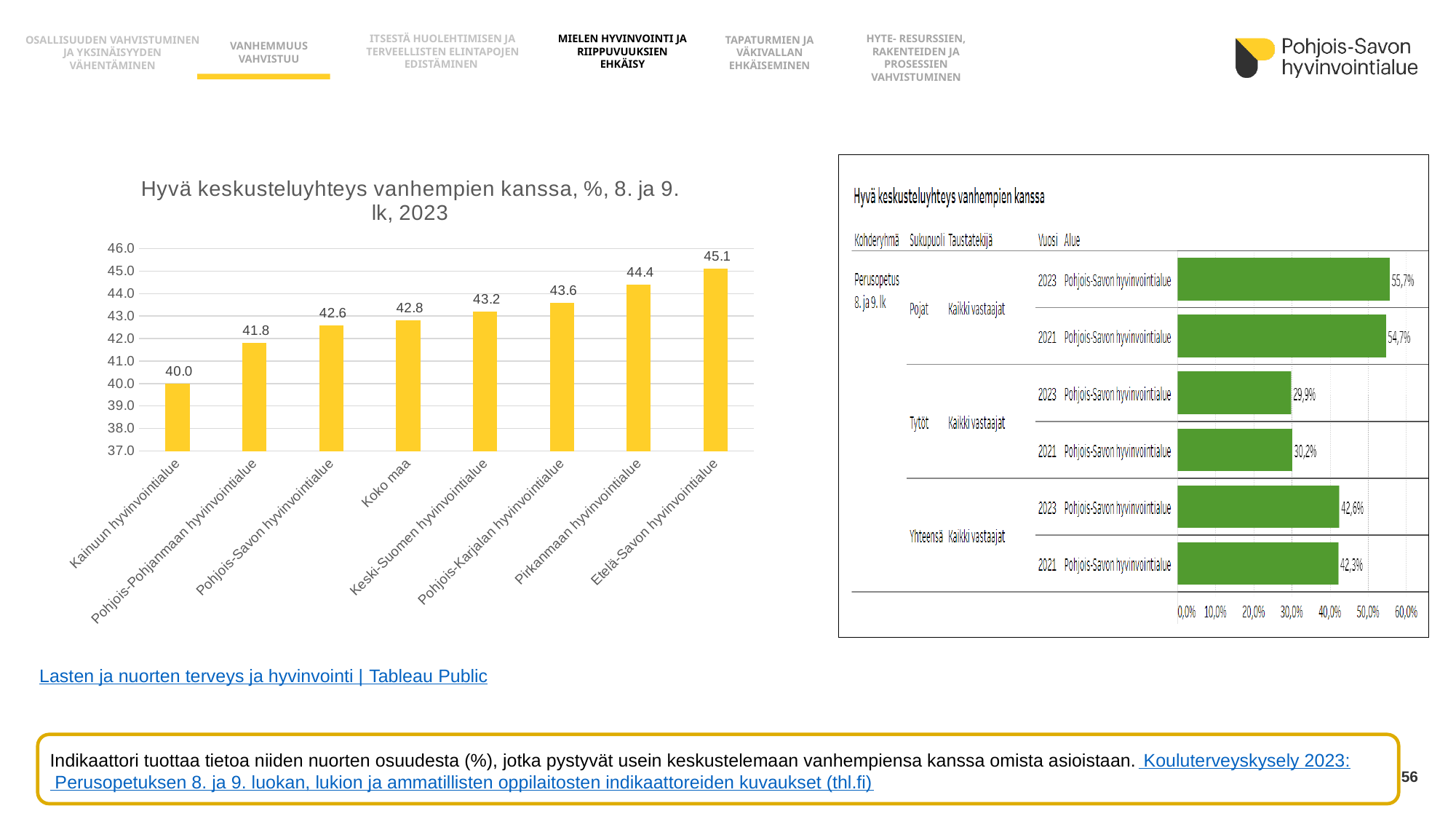
In the left chart, what is the value for Pohjois-Savon hyvinvointialue? 42.6 In the right chart, what is the value for Tytöt in 2021? 30,2% In the left chart, how many regions are shown? 8 What type of chart is the left chart? bar chart In the left chart, which region has the highest value? Etelä-Savon hyvinvointialue In the right chart, which is larger: Yhteensä 2023 or Yhteensä 2021? Yhteensä 2023 In the left chart, what is the difference between Etelä-Savon hyvinvointialue and Kainuun hyvinvointialue? 5.1 In the right chart, what is the difference between Pojat 2023 and Tytöt 2023? 25,8% In the right chart, what is the value for Pojat in 2023? 55,7% In the left chart, what is the value for Koko maa? 42.8 In the left chart, which region has the lowest value? Kainuun hyvinvointialue In the left chart, do the values rise or fall from left to right? rise